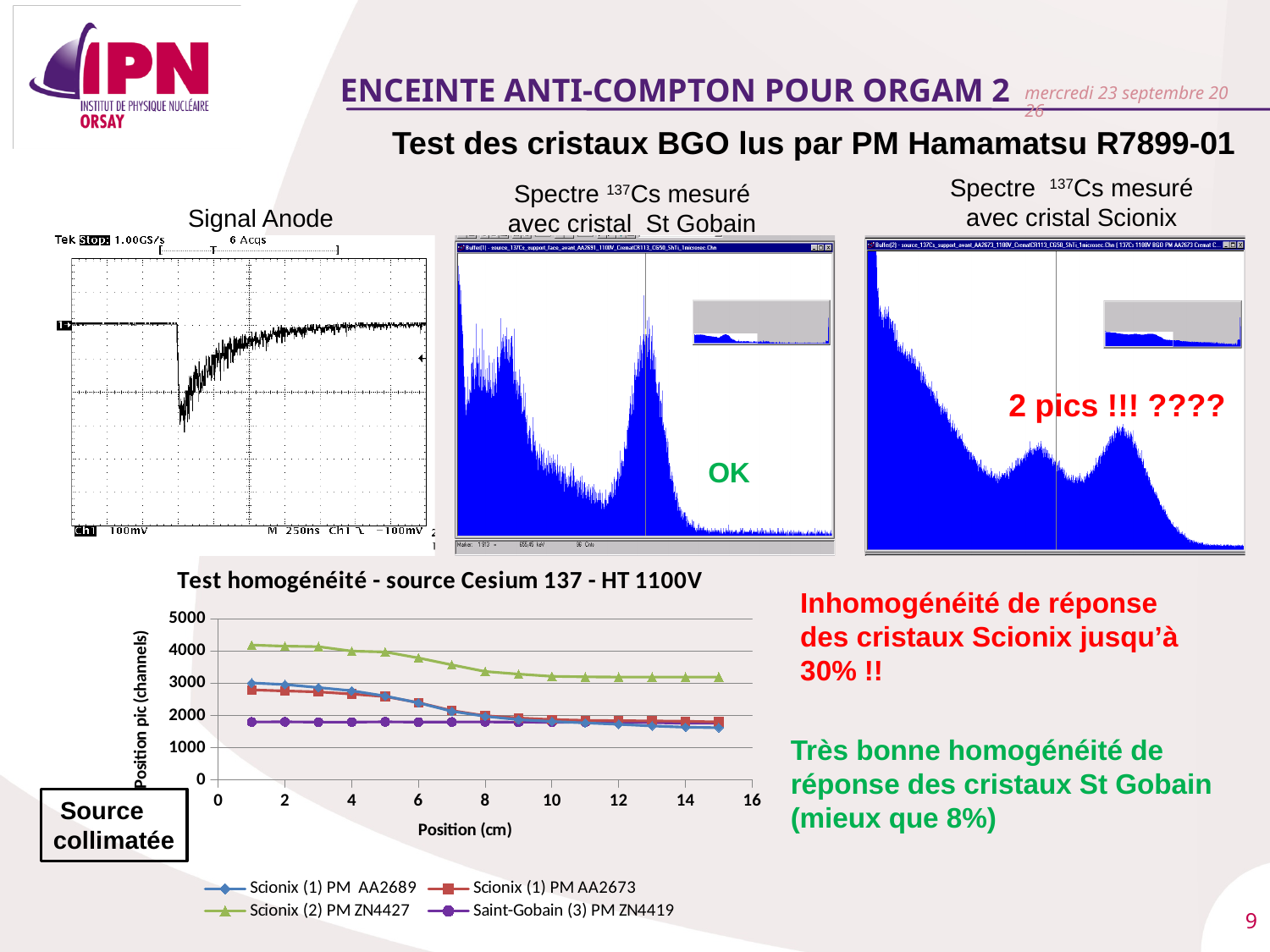
What kind of chart is the 'Test homogénéité - source Cesium 137 - HT 1100V' chart? line chart In the 'Test homogénéité' chart, is the value of Saint-Gobain (3) PM ZN4419 at position 8 cm greater or less than 2000? less How many series does the legend of the 'Test homogénéité' chart list? 4 What is the y-axis label of the 'Test homogénéité' chart? Position pic (channels) In the 'Test homogénéité' chart, at position 1 cm, which is larger: Scionix (1) PM AA2689 or Saint-Gobain (3) PM ZN4419? Scionix (1) PM AA2689 In the 'Test homogénéité' chart, which series has the lowest value at position 1 cm? Saint-Gobain (3) PM ZN4419 How many data points does each series have in the 'Test homogénéité' chart? 15 In the 'Test homogénéité' chart, which series has the highest values across the positions? Scionix (2) PM ZN4427 In the 'Test homogénéité' chart, is the value of Scionix (2) PM ZN4427 at position 1 cm greater or less than 4000? greater What is the x-axis label of the 'Test homogénéité' chart? Position (cm) In the 'Test homogénéité' chart, do the values of Scionix (2) PM ZN4427 rise or fall as position increases? fall In the 'Test homogénéité' chart, is the value of Scionix (1) PM AA2689 at position 15 cm greater or less than 2000? less